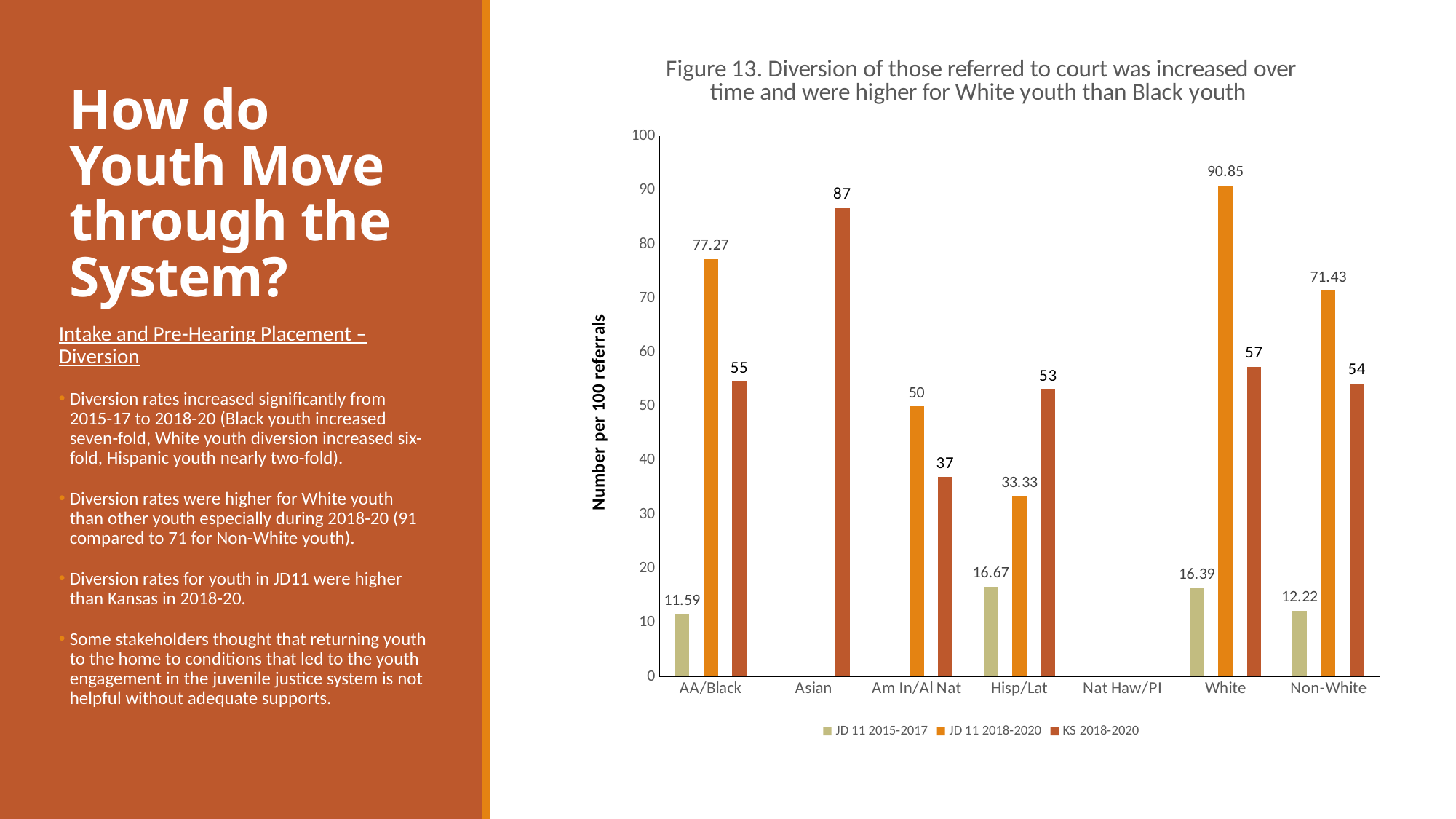
Which category has the lowest JD 11 2015-2017 value? AA/Black What is the JD 11 2015-2017 value for Hisp/Lat? 16.67 For Hisp/Lat, what is the difference between the KS 2018-2020 value and the JD 11 2018-2020 value? 19.67 For AA/Black, which is larger: the JD 11 2018-2020 value or the KS 2018-2020 value? JD 11 2018-2020 Which category has the highest JD 11 2018-2020 value? White What is the difference between the JD 11 2018-2020 values for White and Non-White? 19.42 What is the value for White in the JD 11 2018-2020 series? 90.85 How many series does the legend list? 3 Which category has the highest KS 2018-2020 value? Asian What is the KS 2018-2020 value for Asian? 87 How many categories are shown on the x axis? 7 What is the title of the y axis? Number per 100 referrals